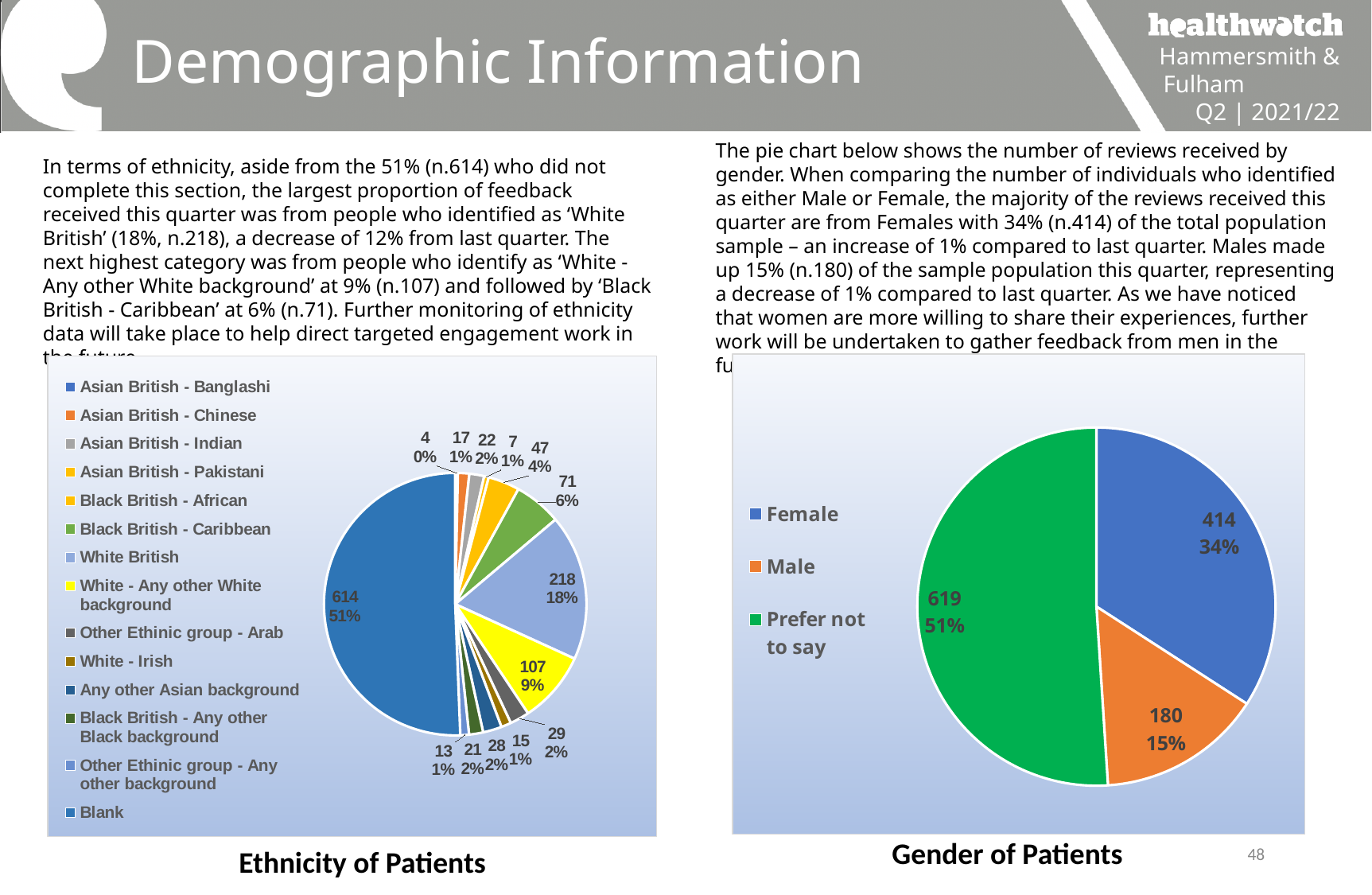
What kind of chart is the Ethnicity of Patients chart? Pie chart In the Gender of Patients chart, which category has the largest slice? Prefer not to say How many categories does the legend of the Ethnicity of Patients chart list? 14 In the Gender of Patients chart, what is the difference between the Female count and the Male count? 234 In the Gender of Patients chart, how many reviews were from Females? 414 How many series does the legend of the Gender of Patients chart list? 3 In the Ethnicity of Patients chart, which is larger: White - Any other White background or Black British - Caribbean? White - Any other White background In the Gender of Patients chart, which category has the smallest slice? Male In the Gender of Patients chart, what percentage of reviews were from Males? 15% In the Ethnicity of Patients chart, how many patients identified as White British? 218 In the Ethnicity of Patients chart, what percentage of patients are in the Blank category? 51% In the Gender of Patients chart, what share of the pie does Prefer not to say represent? 51%